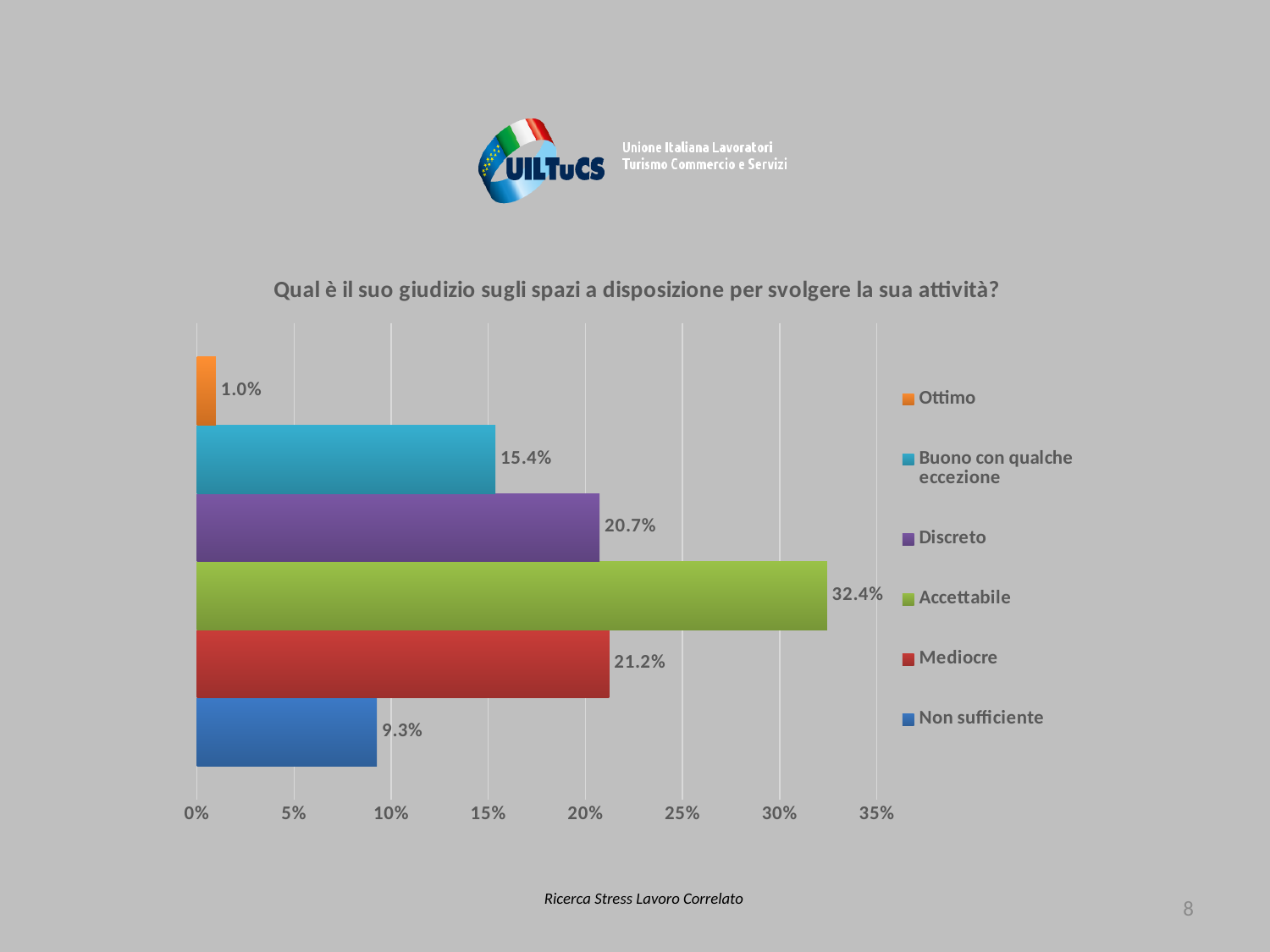
How many entries does the legend list? 6 What colour is the bar for Accettabile? green Which category has the highest value? Accettabile Which category has the lowest value? Ottimo What is the value for Non sufficiente? 9.3% What is the value for Buono con qualche eccezione? 15.4% What is the value for Accettabile? 32.4% How many categories are shown in the chart? 6 What kind of chart is shown on the slide? bar chart Is the value for Discreto greater or less than 20%? greater Which is larger, the value for Mediocre or the value for Buono con qualche eccezione? Mediocre What is the difference between the values for Mediocre and Discreto? 0.5%